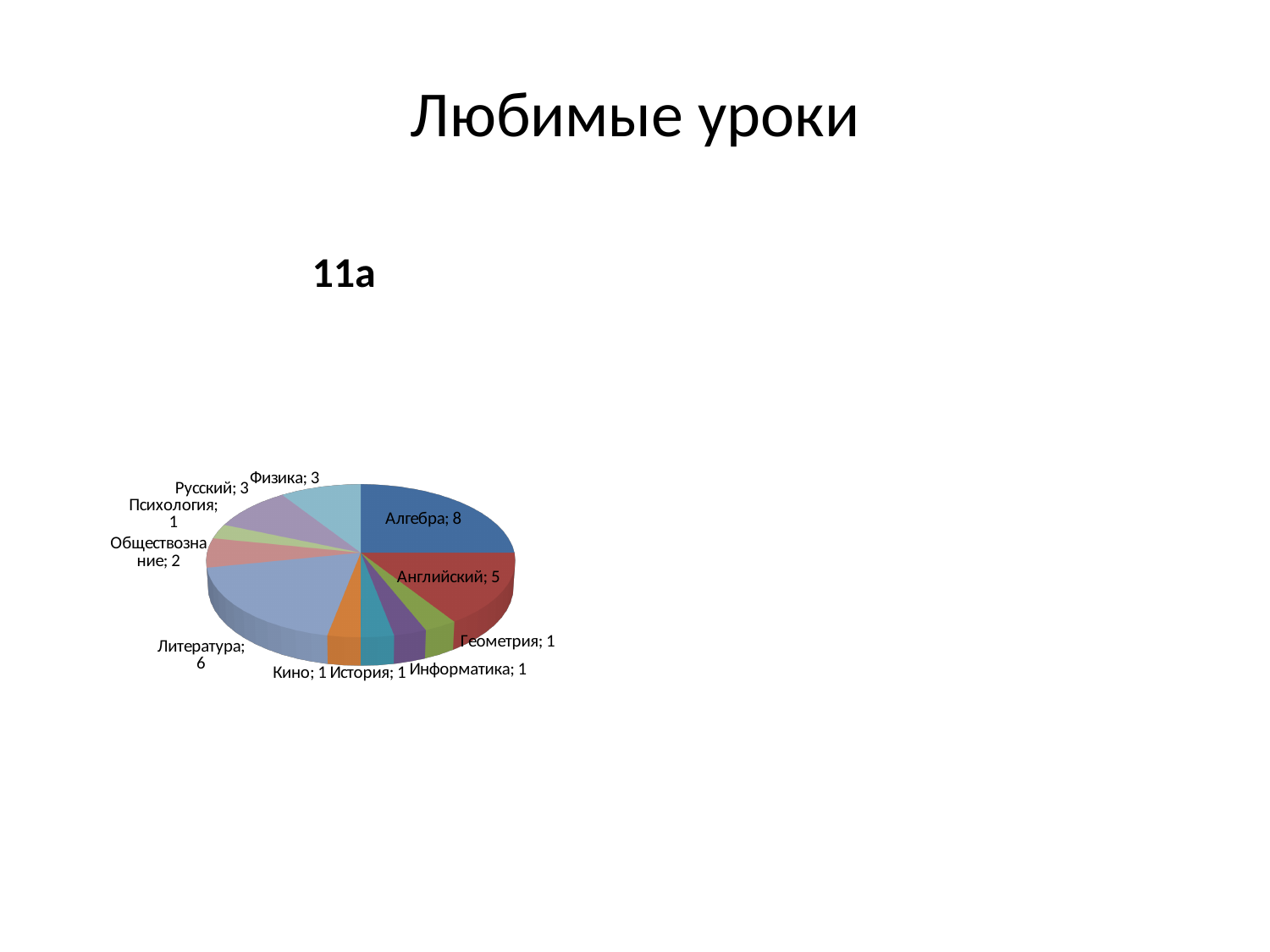
What is the value for Литература? 6 What is the value for Английский? 5 Which is larger, the value for Английский or the value for Физика? Английский How many subjects (slices) are shown in the pie chart? 11 What is the title of the chart? 11а What is the value for Алгебра? 8 What is the total of all the values shown in the pie chart? 32 What share of the pie does Алгебра represent? 25% What is the difference between the values for Алгебра and Литература? 2 What is the value for Обществознание? 2 What kind of chart is shown on the slide? pie chart Which subject has the largest slice of the pie? Алгебра